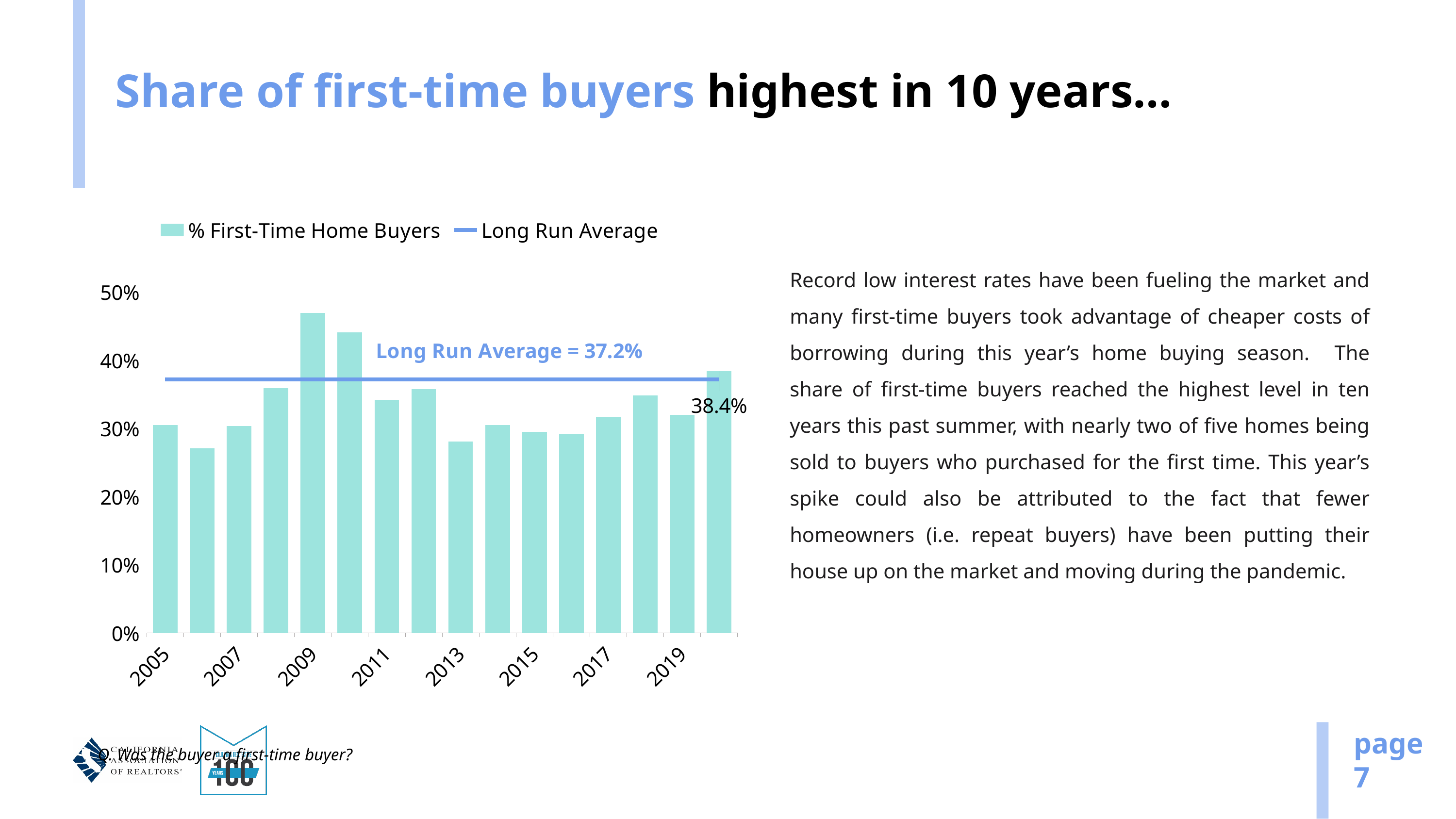
Which year has the larger share of first-time home buyers, 2009 or 2010? 2009 By how many percentage points does the labeled 38.4% value exceed the Long Run Average of 37.2%? 1.2 percentage points Which year has the highest share of first-time home buyers? 2009 Which year has the larger share of first-time home buyers, 2007 or 2008? 2008 Is the value for 2013 greater or less than 30%? less What kind of chart is used to show the share of first-time home buyers? bar chart How many bars (years) are plotted in the chart? 16 Is the value for 2018 greater or less than 40%? less How many series does the legend list? 2 What is the share of first-time home buyers shown by the data label on the last (most recent) bar? 38.4% Is the value for 2009 greater or less than 40%? greater What is the Long Run Average value shown on the chart? 37.2%